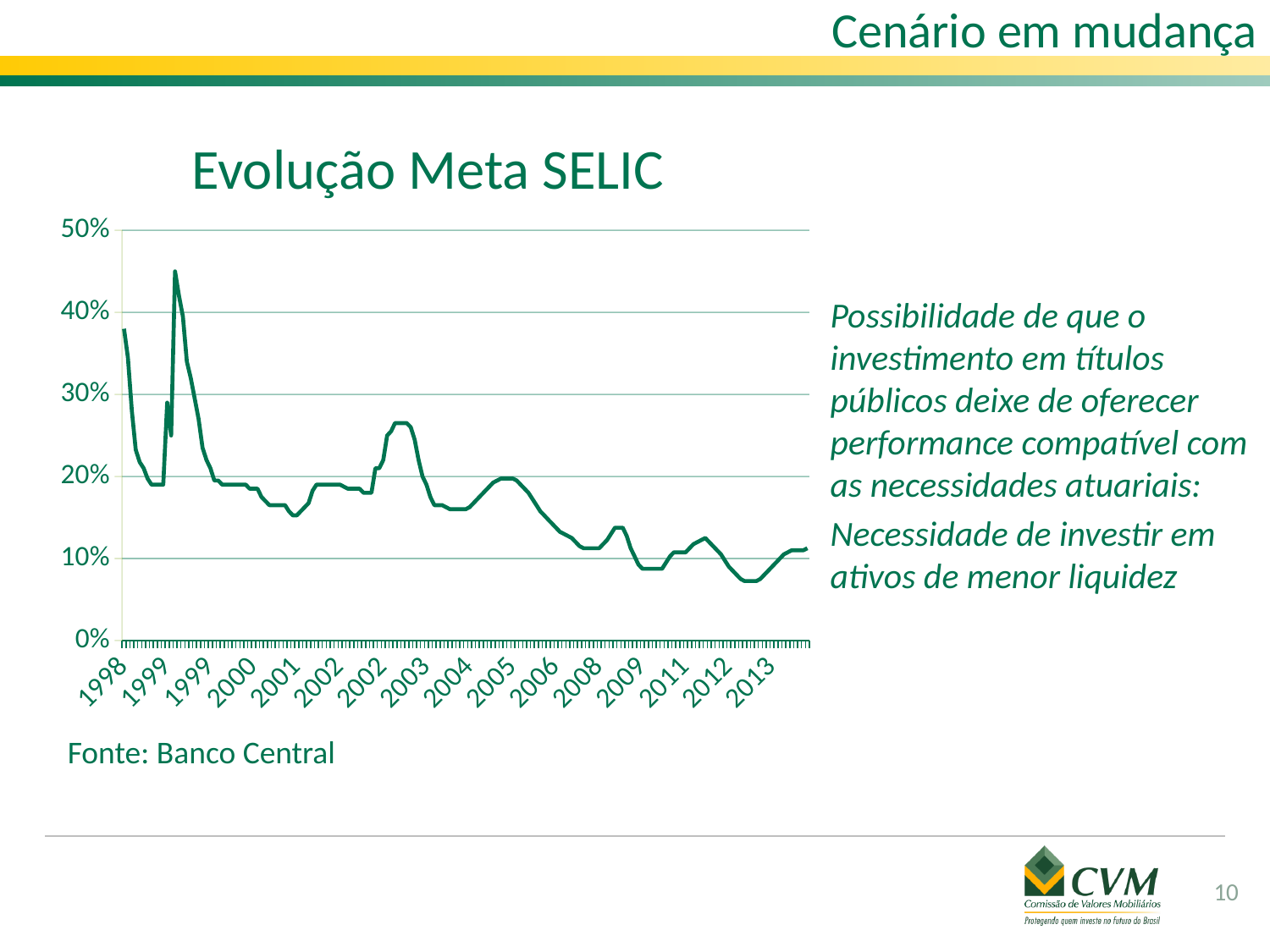
Is the peak value reached in 1999 greater or less than 40%? greater Is the lowest value reached in 2012 greater or less than 10%? less What is the title of the chart? Evolução Meta SELIC Is the value in 2001 greater or less than 20%? less How many lines are plotted on the chart? 1 What kind of chart is shown on the slide? line chart What source is cited below the chart? Banco Central In which year does the line reach its highest point? 1999 Overall, does the SELIC target rise or fall from 1998 to 2013? fall